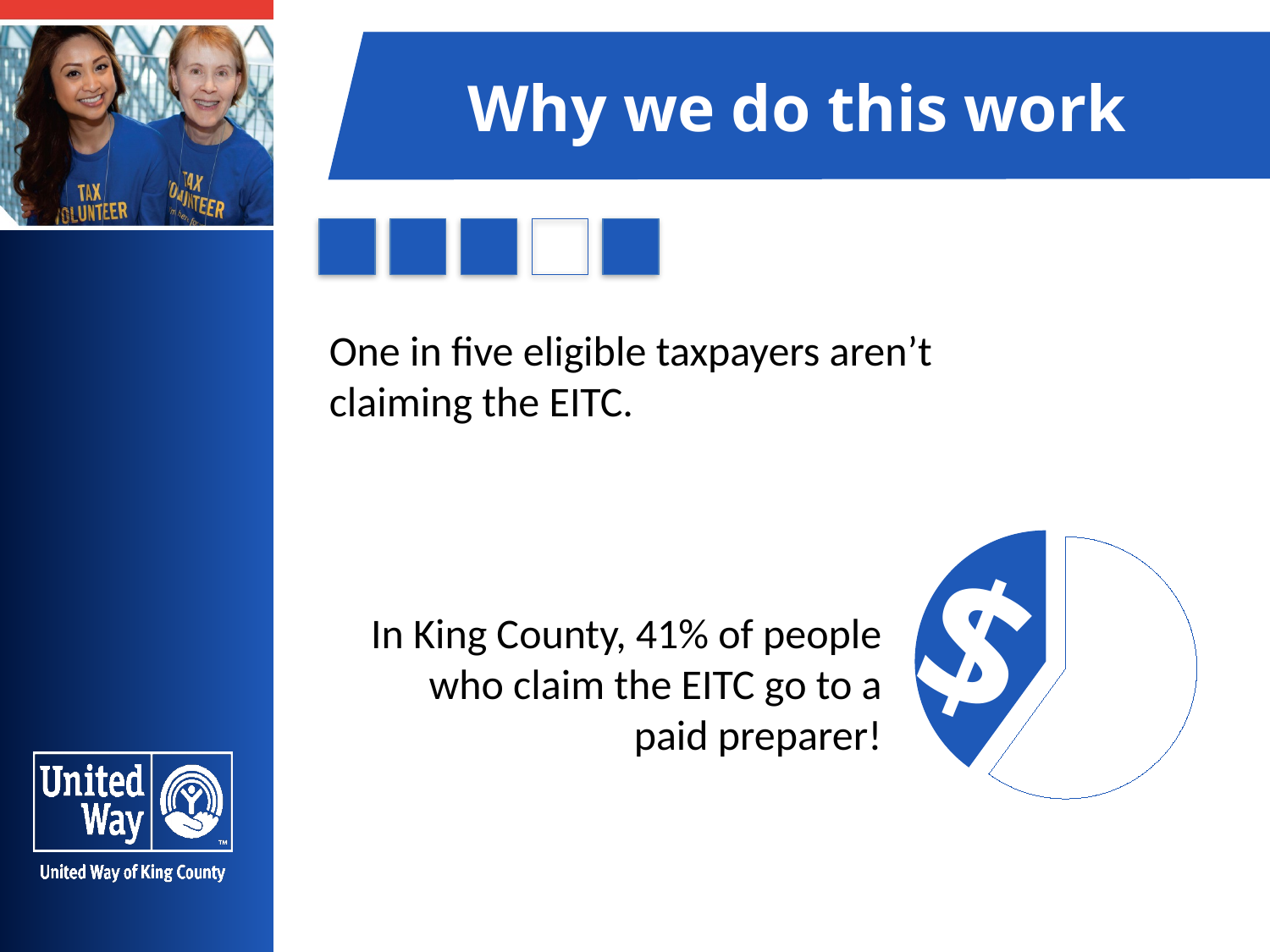
How many of the five squares below the title are white rather than blue? 1 Is the share represented by the blue slice of the pie chart greater or less than 50%? less How many slices does the pie chart have? 2 In the pie chart, which slice is larger, the blue slice or the white slice? the white slice What does the blue slice of the pie chart represent, according to the text beside it? people who claim the EITC and go to a paid preparer in King County What symbol is drawn on the blue slice of the pie chart? a dollar sign ($) What kind of chart is shown at the bottom right of the slide? pie chart How many squares are in the row of squares below the title? 5